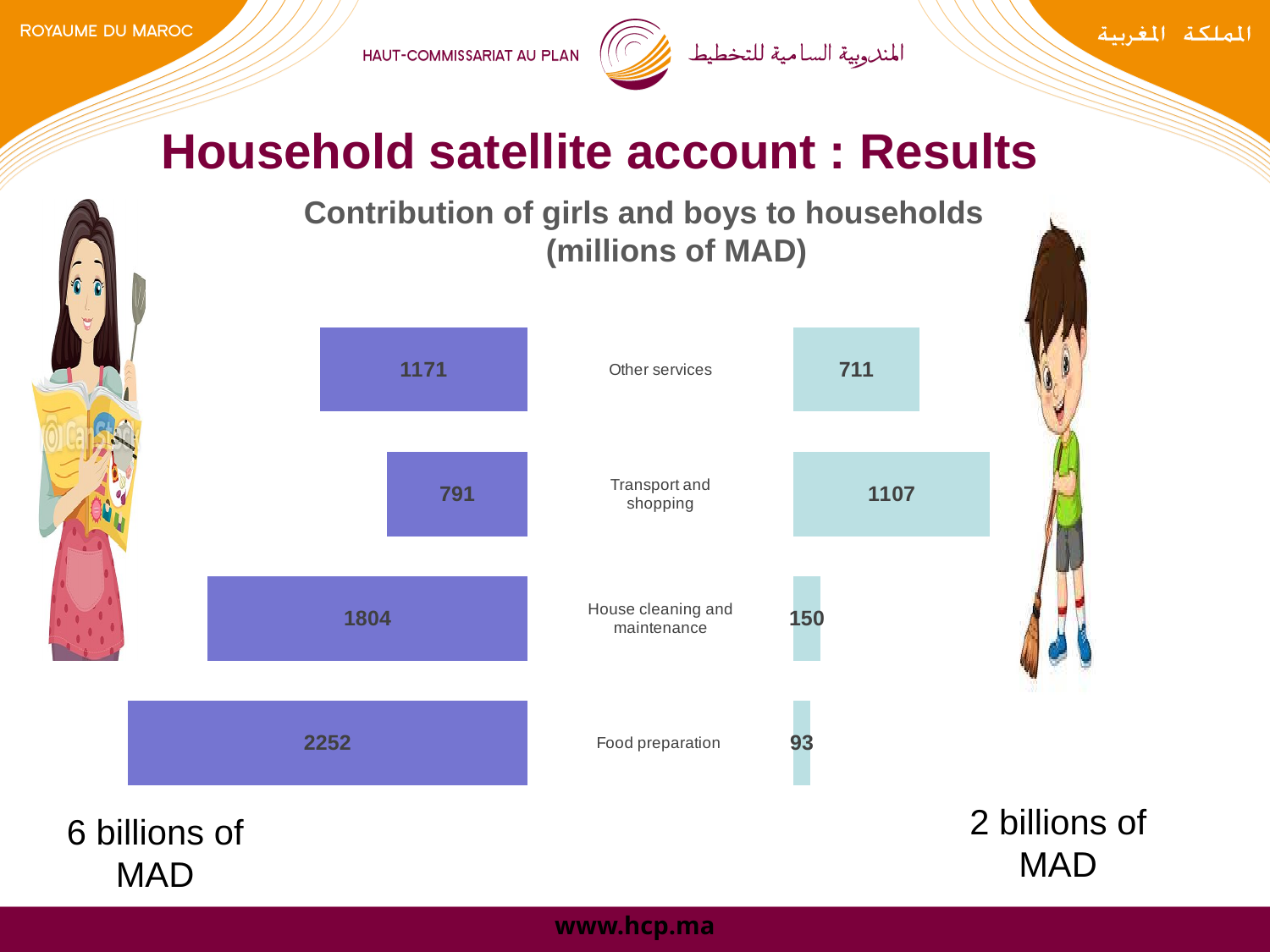
For Transport and shopping, which is larger: the left (purple) bar or the right (light blue) bar? The right (light blue) bar Which category has the lowest value among the right (light blue) bars? Food preparation What is the value of the left (purple) bar for House cleaning and maintenance? 1804 What is the value of the right (light blue) bar for Other services? 711 What is the value of the left (purple) bar for Food preparation? 2252 Which category has the highest value among the right (light blue) bars? Transport and shopping What is the difference between the left (purple) and right (light blue) values for House cleaning and maintenance? 1654 What is the value of the right (light blue) bar for Transport and shopping? 1107 Which category has the highest value among the left (purple) bars? Food preparation What type of chart is shown on the slide? Bar chart How many categories are shown in the chart? 4 What unit is stated in the chart title? millions of MAD